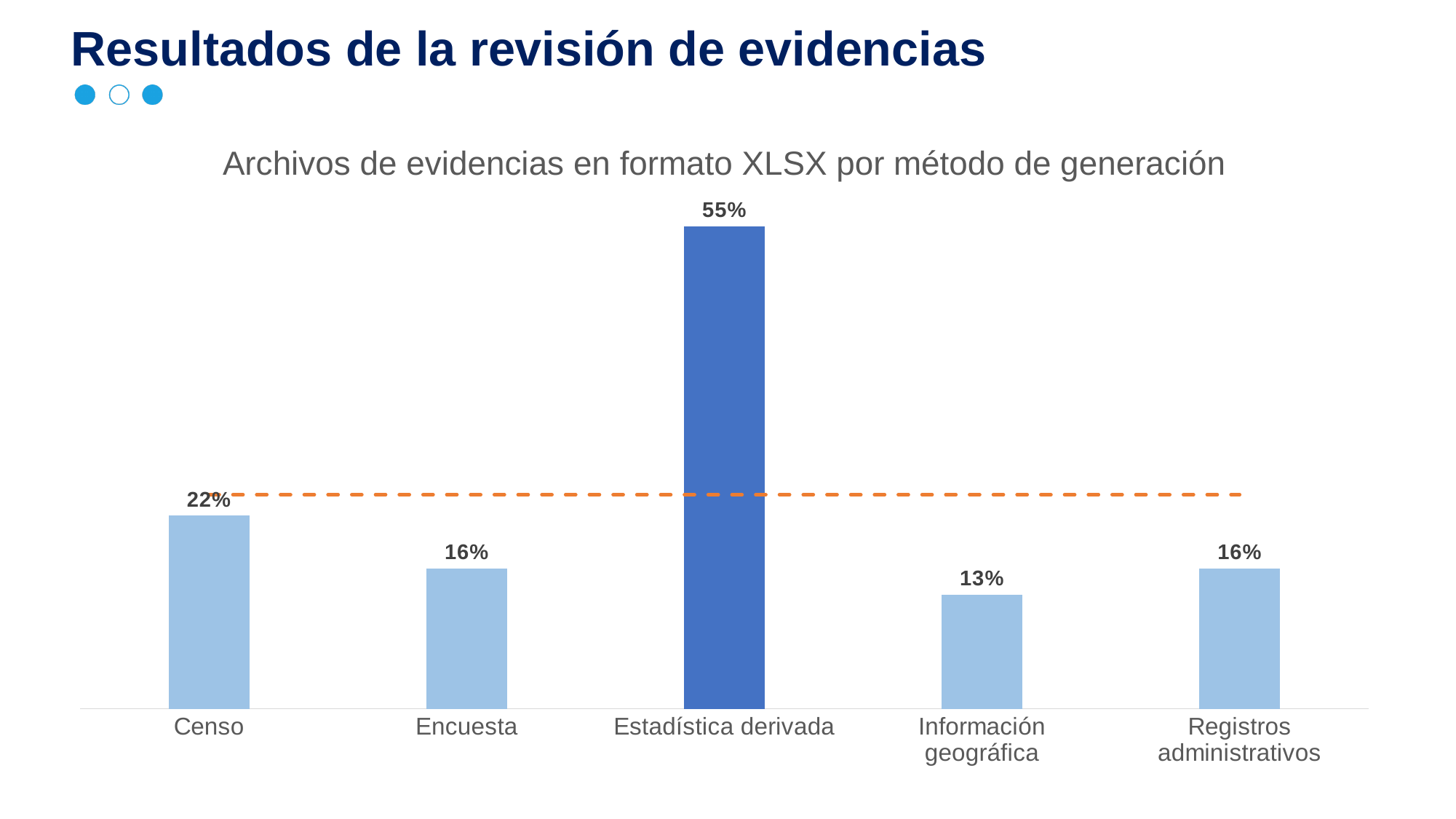
Which is larger, the value for Censo or the value for Registros administrativos? Censo Which category has the lowest value? Información geográfica What is the value for Información geográfica? 13% What is the difference between the values for Estadística derivada and Censo? 33% What is the title of the chart? Archivos de evidencias en formato XLSX por método de generación What is the difference between the values for Censo and Información geográfica? 9% What is the value for Estadística derivada? 55% How many categories are shown on the x axis? 5 What is the value for Censo? 22% Which category has the highest value? Estadística derivada What is the value for Encuesta? 16% What kind of chart is shown on the slide? Bar chart